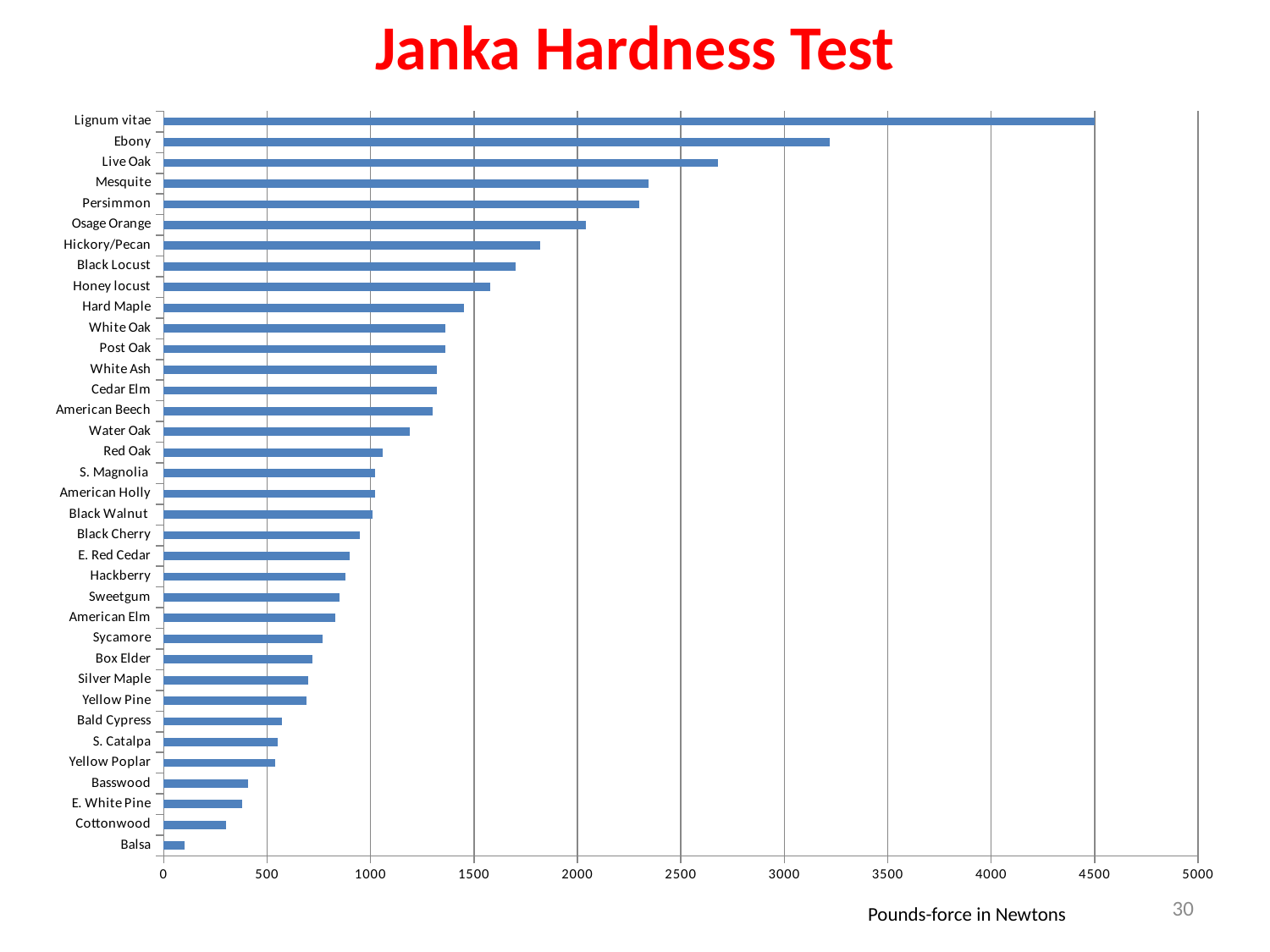
Which has the larger value, Cottonwood or Basswood? Basswood Is the value for Live Oak greater or less than 2500? greater What is the label shown under the horizontal axis? Pounds-force in Newtons Is the value for Hard Maple greater or less than 1500? less How many woods are listed on the chart? 36 What kind of chart is shown on the slide? bar chart Which wood has the lowest Janka hardness value? Balsa Is the value for Balsa greater or less than 500? less Which has the larger value, Ebony or Live Oak? Ebony Which wood has the highest Janka hardness value? Lignum vitae